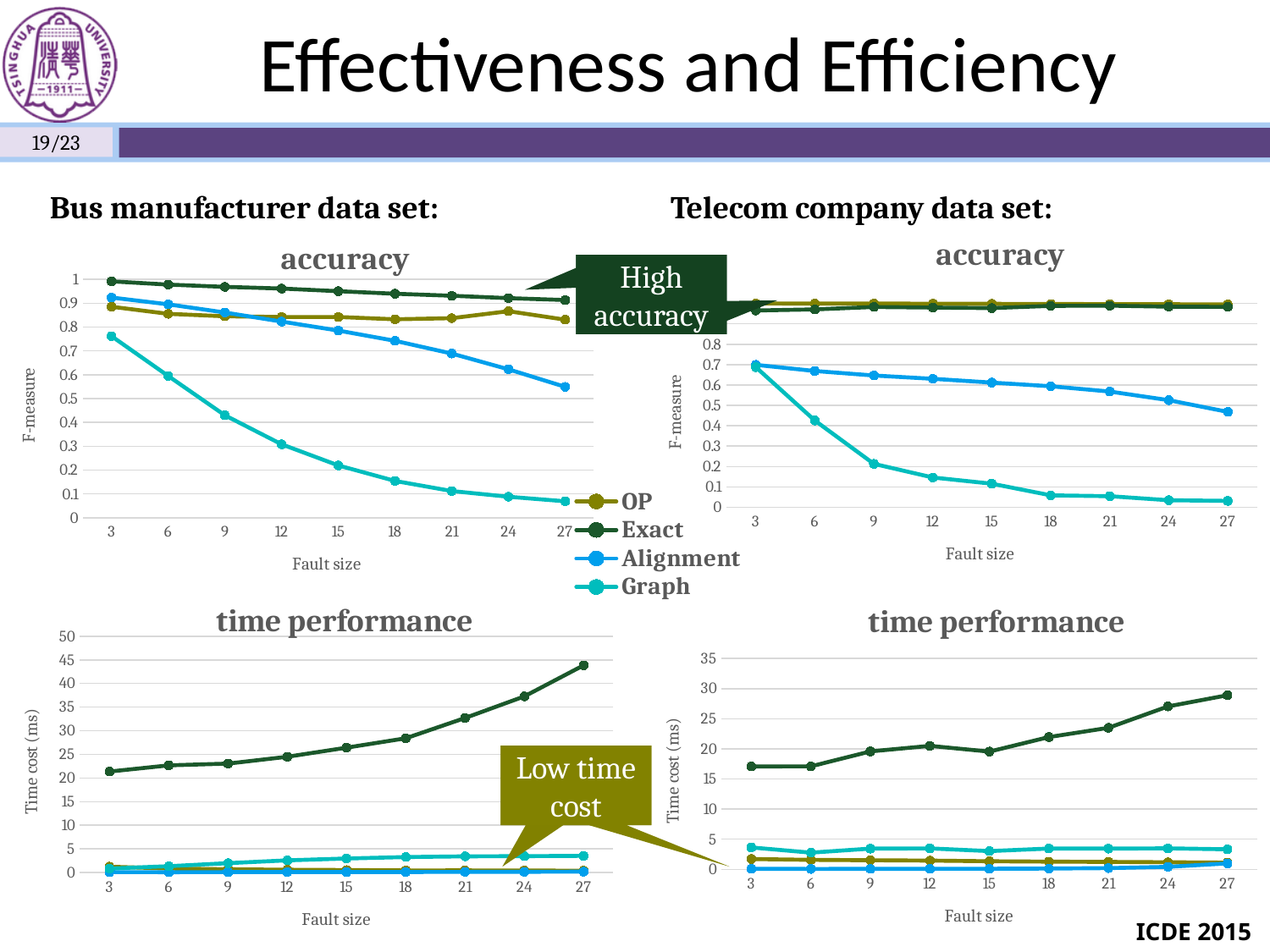
In the Telecom company 'time performance' chart, is the time cost of Exact at fault size 27 greater or less than 25? greater How many series does the legend list for the charts on this slide? 4 What kind of chart is the 'accuracy' chart for the Bus manufacturer data set? line chart How many fault size values are plotted along the x axis of the Bus manufacturer 'accuracy' chart? 9 In the Bus manufacturer 'accuracy' chart, does the F-measure of the Graph series rise or fall as fault size increases? fall In the Bus manufacturer 'time performance' chart, does the time cost of the Exact series rise or fall as fault size increases? rise What is the y-axis label of the Bus manufacturer 'time performance' chart? Time cost (ms) In the Telecom company 'accuracy' chart, is the F-measure of Graph at fault size 27 greater or less than 0.1? less In the Bus manufacturer 'accuracy' chart, which series has the lowest F-measure at fault size 27? Graph In the Telecom company 'accuracy' chart, at fault size 27, which has the higher F-measure: Alignment or Graph? Alignment In the Bus manufacturer 'time performance' chart, which series has the highest time cost? Exact In the Bus manufacturer 'time performance' chart, is the time cost of Exact at fault size 27 greater or less than 40? greater